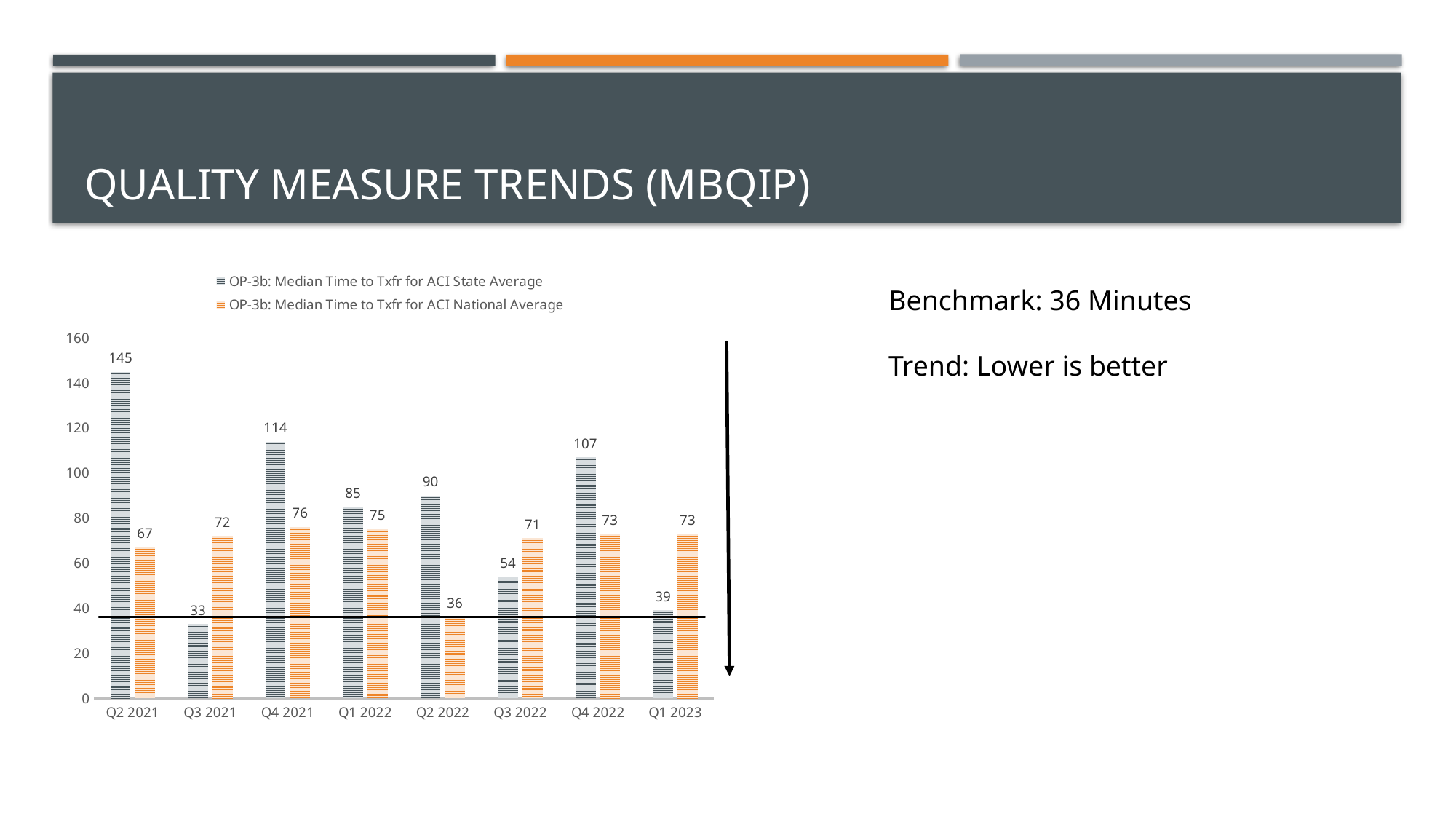
What is the OP-3b State Average value for Q1 2023? 39 How many series does the legend list? 2 What is the OP-3b National Average value for Q4 2021? 76 What kind of chart is shown on the slide? Bar chart In which quarter is the National Average lowest? Q2 2022 What is the difference between the State Average and the National Average in Q4 2022? 34 In which quarter is the State Average highest? Q2 2021 What benchmark value is stated on the slide? 36 Minutes What is the OP-3b State Average value for Q2 2021? 145 Which is larger in Q3 2022, the State Average or the National Average? National Average In which quarter is the State Average lowest? Q3 2021 How many quarters are shown on the x axis? 8